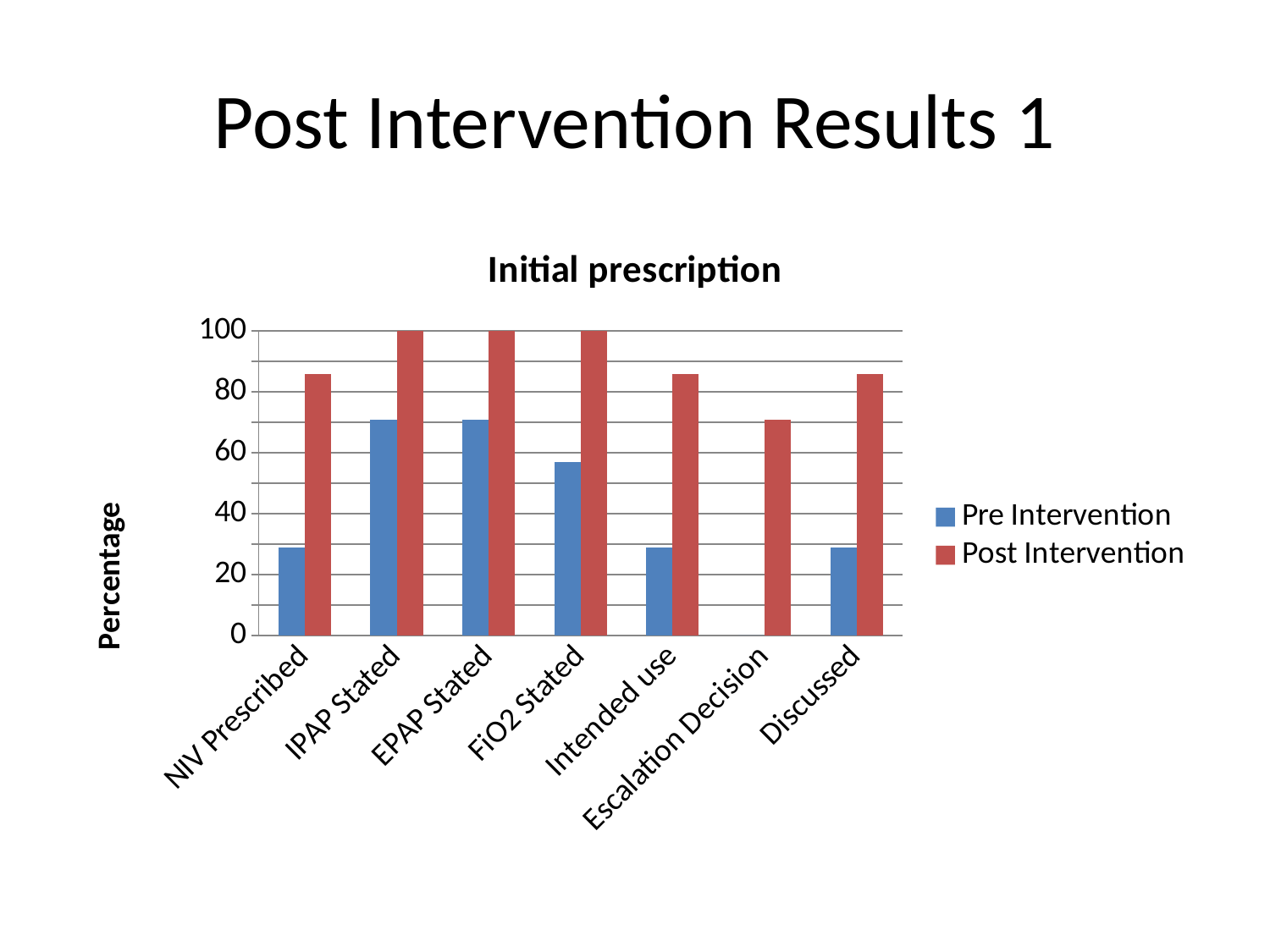
Is the Pre Intervention value for FiO2 Stated greater or less than 40? greater What kind of chart is shown on the slide? bar chart How many categories are shown on the x axis? 7 What is the Post Intervention value for IPAP Stated? 100 How many series does the legend list? 2 What is the title of the chart? Initial prescription Which category has the lowest Post Intervention value? Escalation Decision Which is larger for Intended use, the Pre Intervention value or the Post Intervention value? Post Intervention Is the Pre Intervention value for NIV Prescribed greater or less than 40? less What is the Post Intervention value for FiO2 Stated? 100 Is the Post Intervention value for Escalation Decision greater or less than 60? greater What is the label on the vertical axis? Percentage